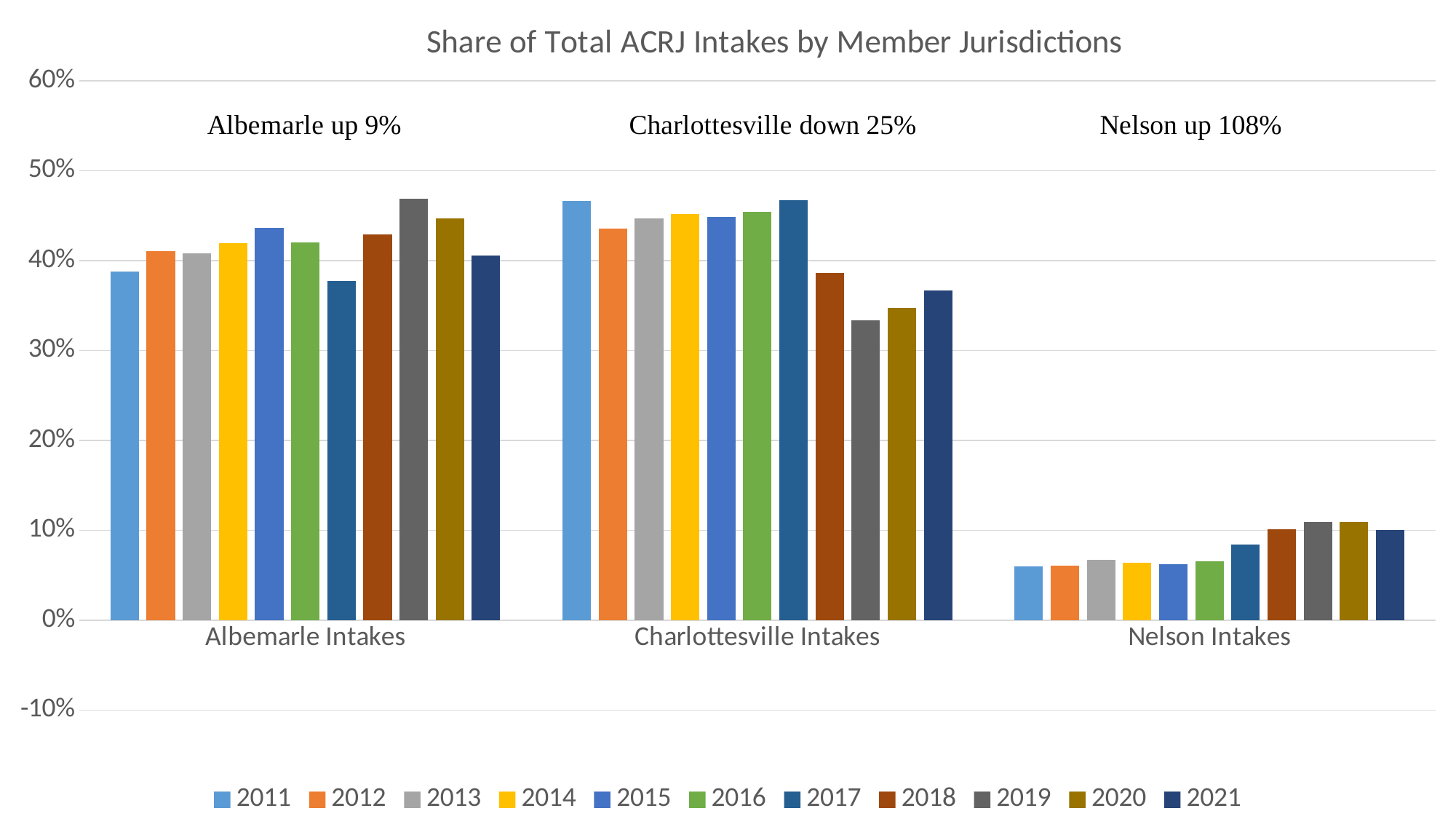
How many jurisdiction categories are shown on the x axis? 3 How many series does the legend list? 11 Is the value for Albemarle Intakes in 2019 greater or less than 40%? greater Which year has the highest value for Albemarle Intakes? 2019 Do the Nelson Intakes values rise or fall from 2016 to 2019? rise What kind of chart is shown on the slide? bar chart Is the value for Charlottesville Intakes in 2019 greater or less than 40%? less For Charlottesville Intakes, which is larger: the 2011 value or the 2019 value? 2011 Which year has the lowest value for Charlottesville Intakes? 2019 What is the title of the chart? Share of Total ACRJ Intakes by Member Jurisdictions For Albemarle Intakes, which is larger: the 2017 value or the 2019 value? 2019 Is the value for Nelson Intakes in 2011 greater or less than 10%? less